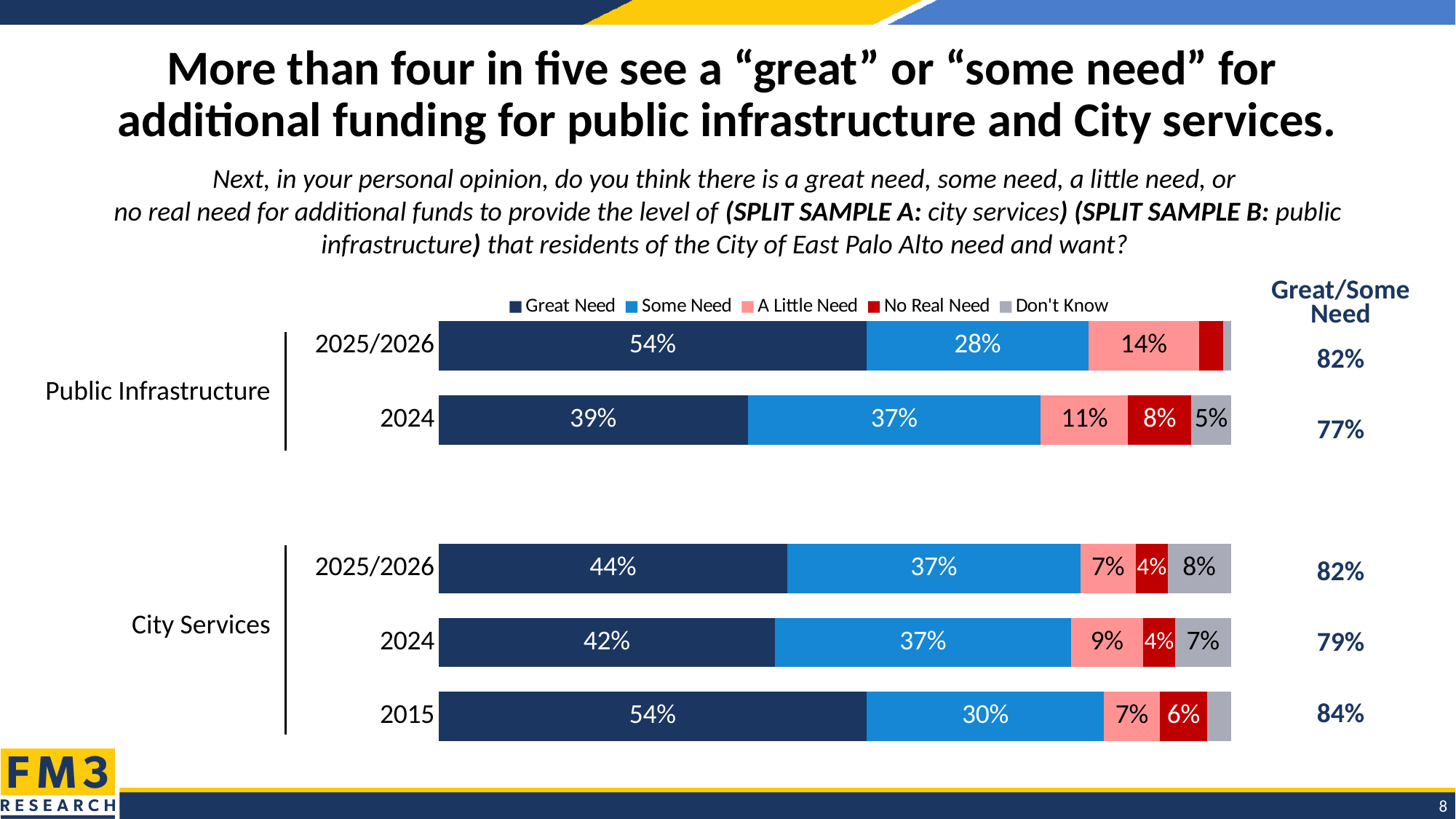
What is the "Some Need" value for City Services in 2024? 37% By how many percentage points did "Great Need" for Public Infrastructure change from 2024 to 2025/2026? 15 percentage points Which bar has the highest Great/Some Need total? City Services 2015 (84%) What is the "A Little Need" value for City Services in 2015? 7% How many bars are plotted in the chart? 5 What is the "Don't Know" value for City Services in 2025/2026? 8% What kind of chart is shown on the slide? Stacked bar chart What is the combined Great/Some Need figure shown for Public Infrastructure in 2024? 77% How many series does the legend list? 5 For Public Infrastructure, which year has the larger "Some Need" share, 2024 or 2025/2026? 2024 What percentage of respondents said there is a "Great Need" for Public Infrastructure in 2025/2026? 54% What is the "No Real Need" value for Public Infrastructure in 2024? 8%